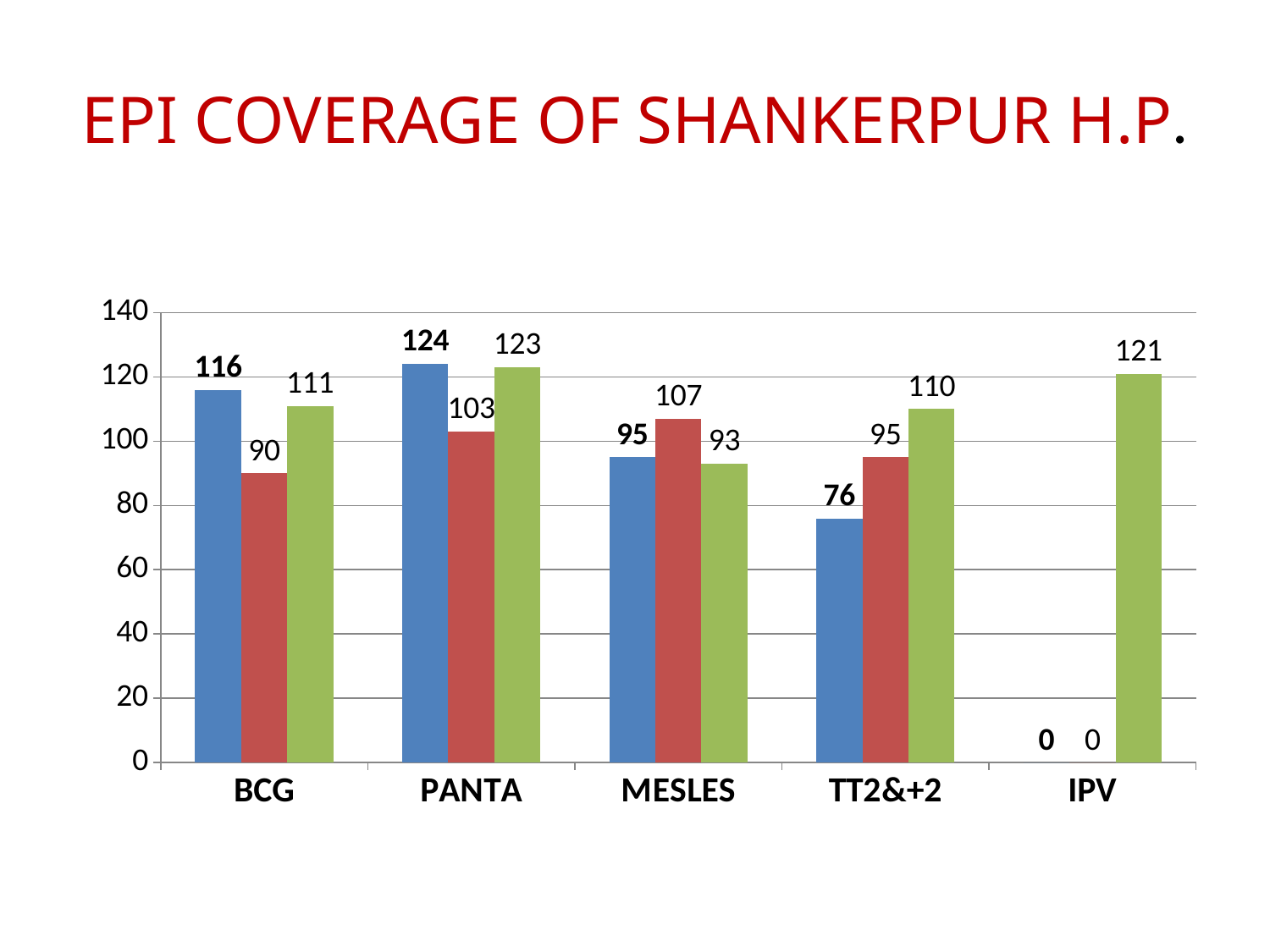
Which category has the highest blue bar? PANTA What is the difference between the blue bar and the red bar for BCG? 26 What kind of chart is shown on the slide? bar chart Which is larger for TT2&+2, the red bar or the green bar? the green bar What is the value of the blue bar for TT2&+2? 76 What is the value of the green bar for IPV? 121 What is the value of the blue bar for BCG? 116 What is the value of the red bar for MESLES? 107 Which category has the lowest green bar? MESLES How many differently coloured bars are shown for each category? 3 How many categories are shown on the x axis? 5 What is the title of the slide? EPI COVERAGE OF SHANKERPUR H.P.